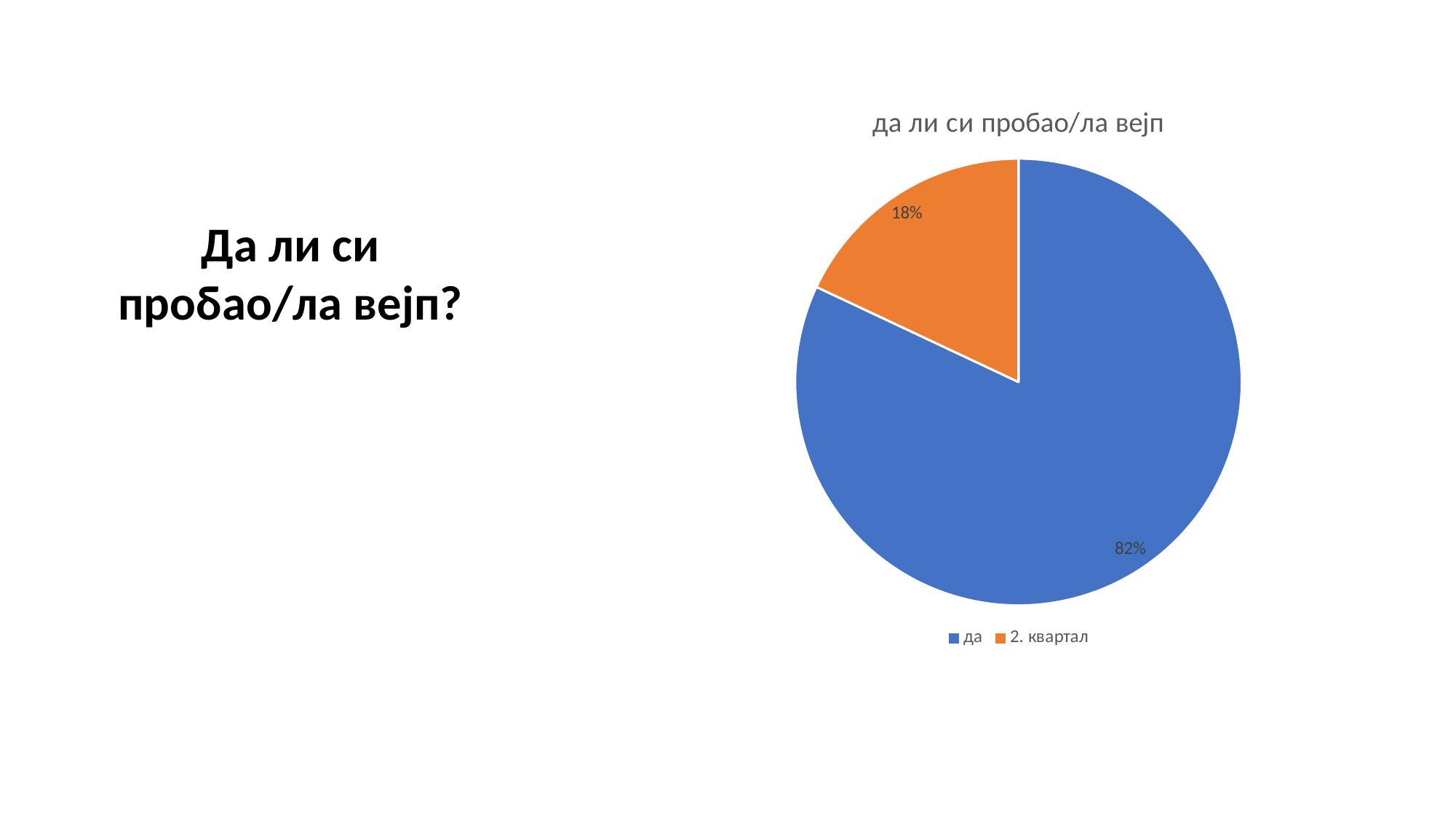
Which slice is the largest in the pie chart? да What colour is the "2. квартал" slice? orange What share of the pie does the "да" slice represent? 82% What share of the pie does the "2. квартал" slice represent? 18% What is the difference in percentage points between the "да" slice and the "2. квартал" slice? 64 What is the title of the chart? да ли си пробао/ла вејп Which slice is the smallest in the pie chart? 2. квартал What kind of chart is shown on the slide? pie chart How many entries does the legend list? 2 Which is larger, the "да" slice or the "2. квартал" slice? да How many slices does the pie chart have? 2